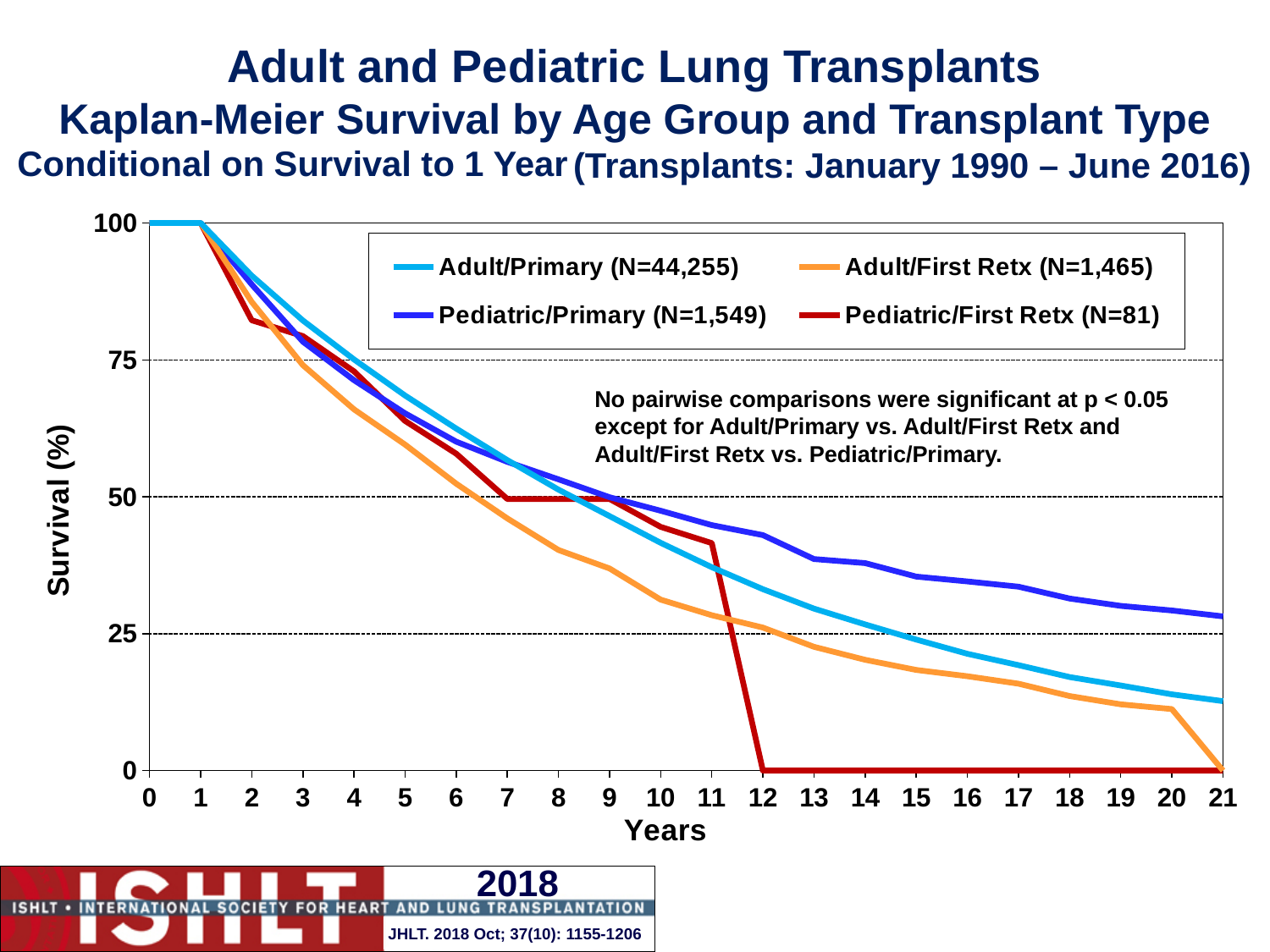
Is the value for Adult/Primary at year 5 greater or less than 50? greater Is the value for Pediatric/Primary at year 21 greater or less than 25? greater What kind of chart is shown on the slide? Line chart What is the N shown in the legend for Adult/Primary? N=44,255 How many series does the legend list? 4 Do the survival values rise or fall as years increase? Fall What is the survival value for Adult/Primary at year 0? 100 Is the value for Adult/Primary at year 21 greater or less than 25? less Which series has the lowest survival at year 15? Pediatric/First Retx At year 15, which is higher: Adult/Primary or Adult/First Retx? Adult/Primary What is the survival value for Pediatric/First Retx at year 15? 0 Which series has the highest survival at year 21? Pediatric/Primary